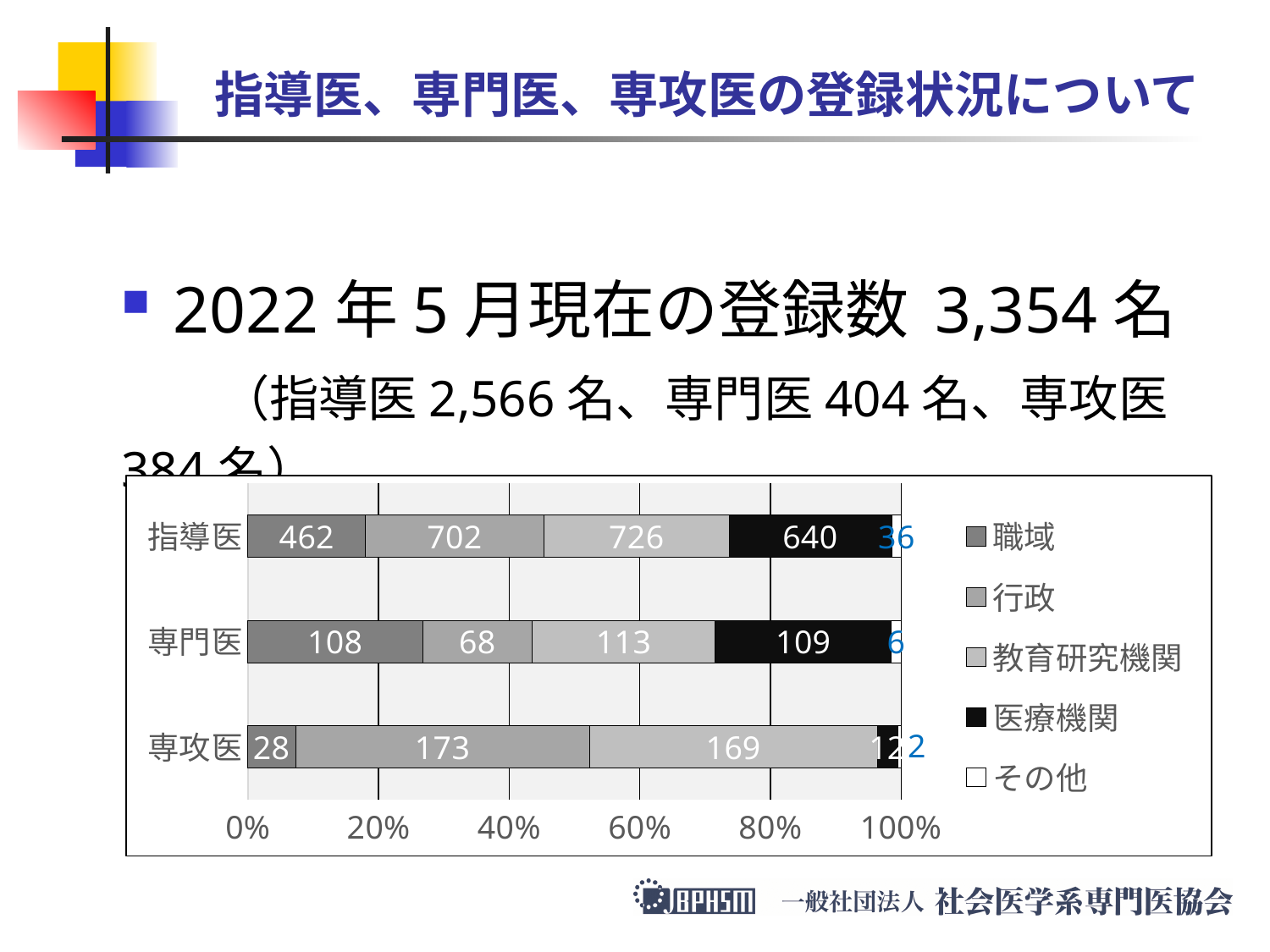
What is the difference between 教育研究機関 and 行政 for 専攻医? -4 What is the value of 医療機関 for 専門医? 109 What is the total of the 専門医 bar? 404 What is the value of 職域 for 専攻医? 28 Which is larger for 専門医: 職域 or 行政? 職域 How many categories (bars) are shown in the chart? 3 What is the value of その他 for 指導医? 36 How many series does the legend list? 5 What kind of chart is shown on the slide? Stacked bar chart Which series has the largest value in the 指導医 bar? 教育研究機関 Which series has the smallest value in the 専攻医 bar? その他 What is the value of 行政 for 指導医? 702